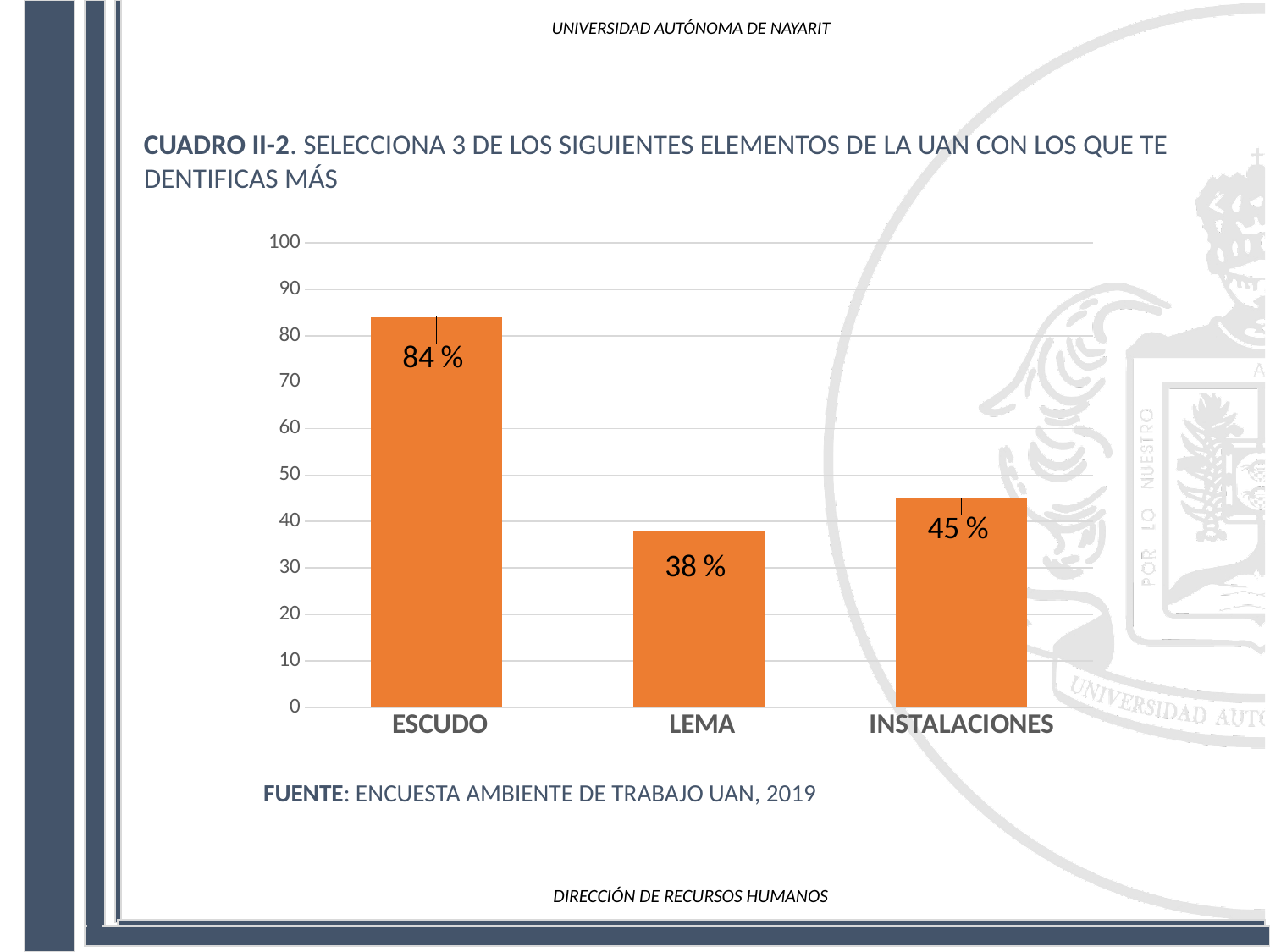
How many categories are shown in the chart? 3 What is the value for LEMA? 38 % What kind of chart is shown on the slide? bar chart What is the difference between the values for ESCUDO and LEMA? 46 % Is the value for ESCUDO greater or less than 80? greater What source is cited below the chart? ENCUESTA AMBIENTE DE TRABAJO UAN, 2019 What is the value for INSTALACIONES? 45 % What is the difference between the values for INSTALACIONES and LEMA? 7 % Which category has the lowest value? LEMA Which is larger, the value for INSTALACIONES or the value for LEMA? INSTALACIONES Which category has the highest value? ESCUDO What is the value for ESCUDO? 84 %